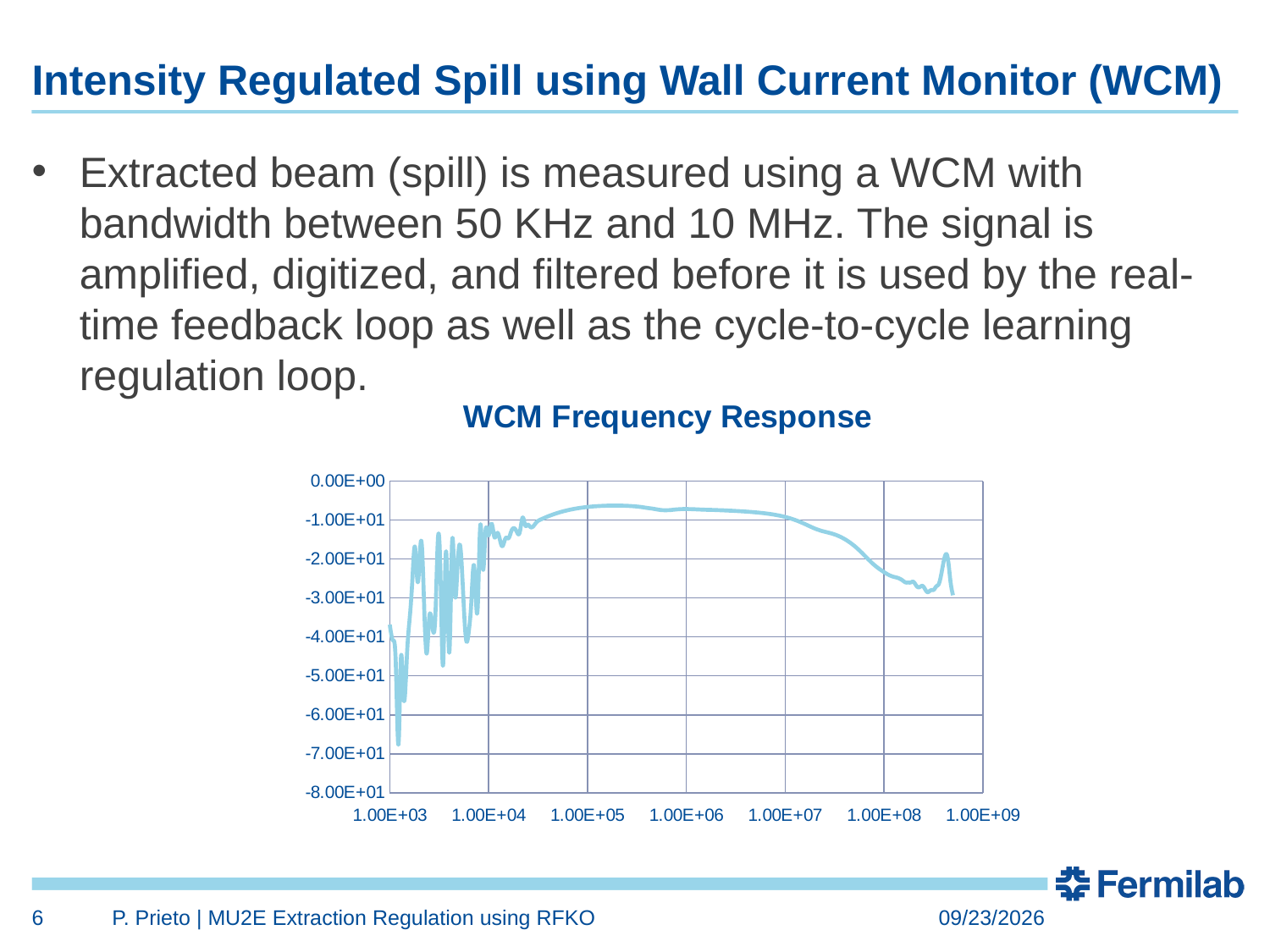
In the WCM Frequency Response chart, do the values rise or fall between 1.00E+07 and 1.00E+08? fall In the WCM Frequency Response chart, is the value at 1.00E+03 greater or less than -3.00E+01? less In the WCM Frequency Response chart, is the lowest point of the curve greater or less than -5.00E+01? less What is the title of the chart on the slide? WCM Frequency Response In the WCM Frequency Response chart, do the values generally rise or fall between 1.00E+04 and 1.00E+05? rise What is the lowest value labelled on the y axis of the WCM Frequency Response chart? -8.00E+01 In the WCM Frequency Response chart, is the value at 1.00E+08 greater or less than -1.00E+01? less How many tick labels are shown on the x axis of the WCM Frequency Response chart? 7 In the WCM Frequency Response chart, which is larger, the value at 1.00E+05 or the value at 1.00E+08? the value at 1.00E+05 What kind of chart is shown on the slide? line chart